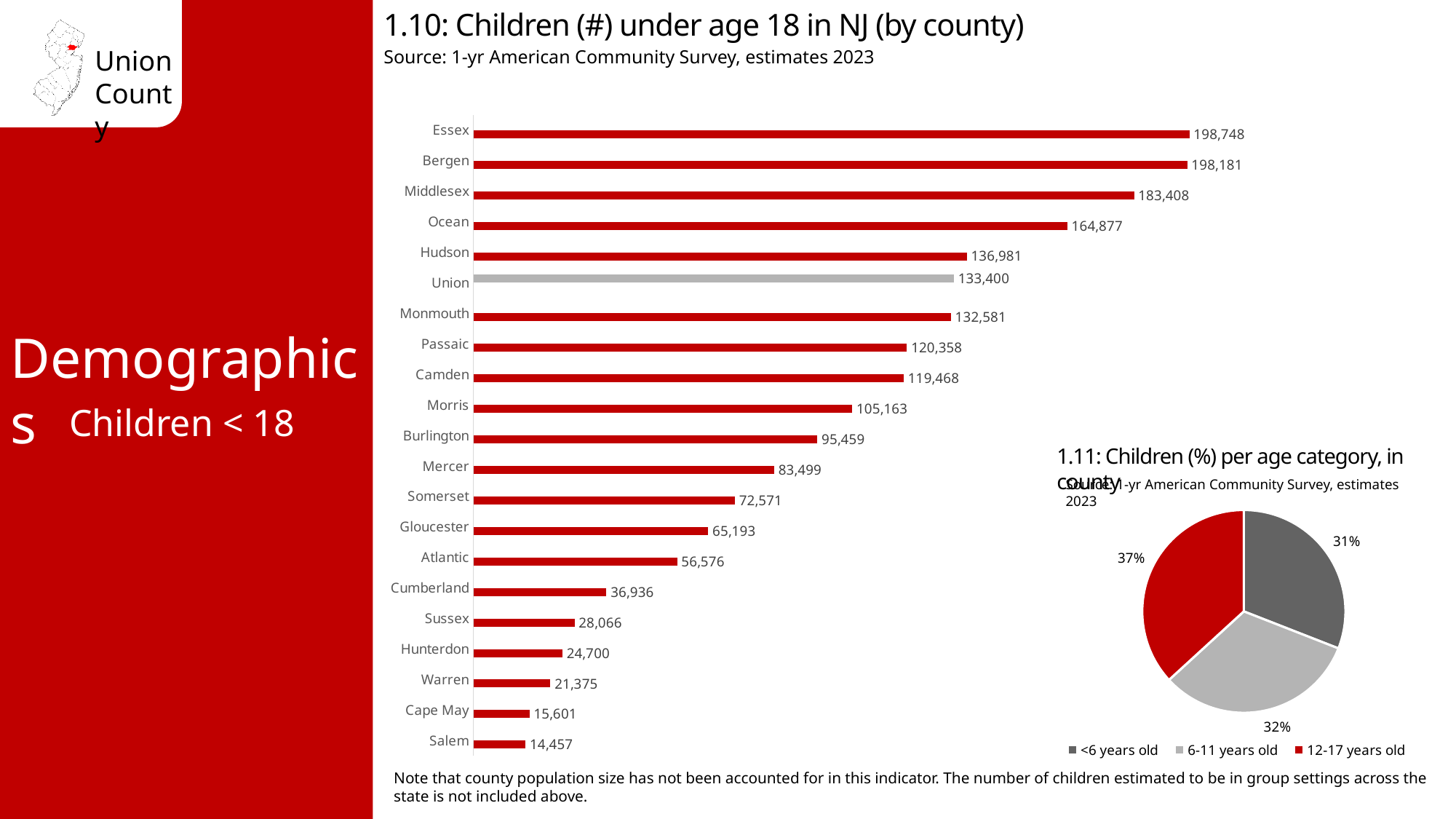
In the chart '1.11: Children (%) per age category, in county', which age category has the largest share? 12-17 years old In the chart '1.10: Children (#) under age 18 in NJ (by county)', how many counties are shown? 21 In the chart '1.11: Children (%) per age category, in county', what share is shown for 6-11 years old? 32% In the chart '1.10: Children (#) under age 18 in NJ (by county)', what is the value for Cape May? 15,601 In the chart '1.10: Children (#) under age 18 in NJ (by county)', which county has the lowest value? Salem What kind of chart is '1.10: Children (#) under age 18 in NJ (by county)'? Bar chart In the chart '1.10: Children (#) under age 18 in NJ (by county)', which county has the highest value? Essex In the chart '1.10: Children (#) under age 18 in NJ (by county)', which bar is coloured grey instead of red? Union How many entries does the legend of the chart '1.11: Children (%) per age category, in county' list? 3 In the chart '1.10: Children (#) under age 18 in NJ (by county)', what is the difference between the values for Hudson and Union? 3,581 In the chart '1.10: Children (#) under age 18 in NJ (by county)', what is the value for Union? 133,400 In the chart '1.10: Children (#) under age 18 in NJ (by county)', which is larger, the value for Passaic or the value for Camden? Passaic